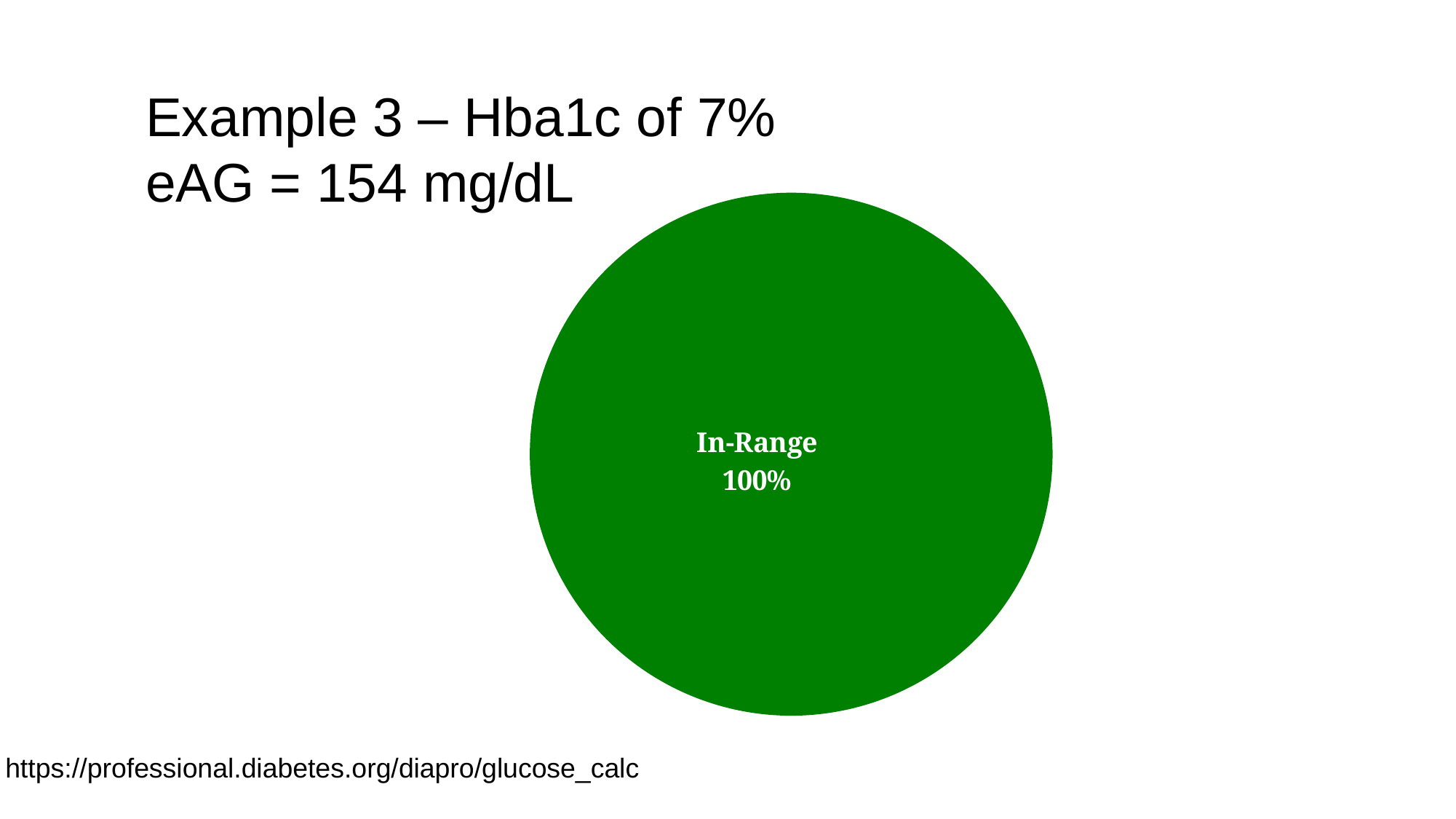
Is the value for In-Range greater or less than 50%? greater What is the value shown for the In-Range slice? 100% What kind of chart is shown on the slide? pie chart What share of the pie chart does the In-Range slice represent? 100% How many slices does the pie chart have? 1 What is the label of the only slice in the pie chart? In-Range What colour is the In-Range slice of the pie chart? green